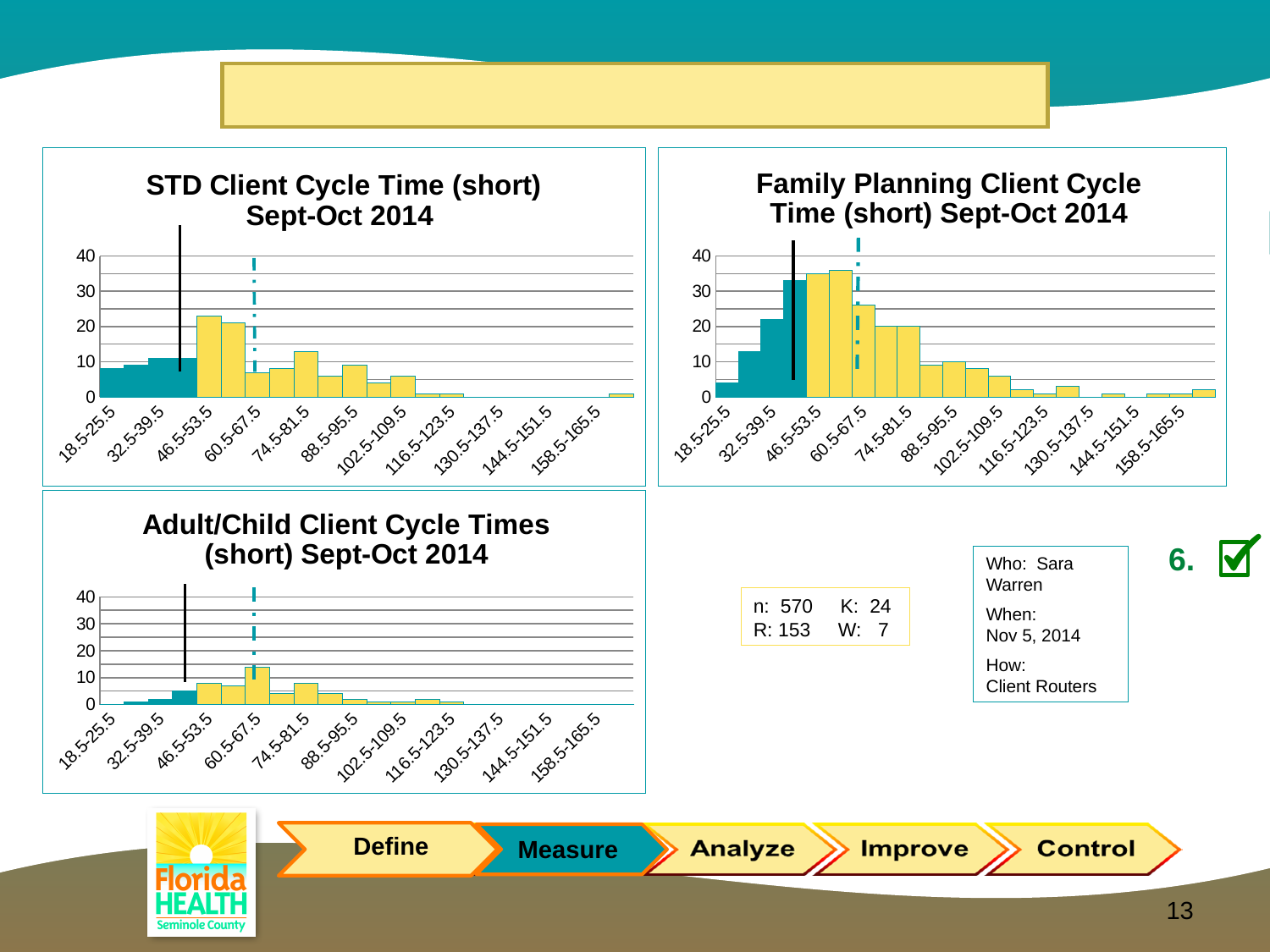
In the "Adult/Child Client Cycle Times (short) Sept-Oct 2014" chart, is the value for 18.5-25.5 greater or less than 10? less Which chart has the tallest bar overall: the STD chart, the Family Planning chart, or the Adult/Child chart? Family Planning Client Cycle Time (short) Sept-Oct 2014 In the "Family Planning Client Cycle Time (short) Sept-Oct 2014" chart, is the tallest bar greater or less than 30? greater In the "Adult/Child Client Cycle Times (short) Sept-Oct 2014" chart, is the tallest bar greater or less than 20? less What is the highest value shown on the y-axis of the "STD Client Cycle Time (short) Sept-Oct 2014" chart? 40 What kind of chart is the "STD Client Cycle Time (short) Sept-Oct 2014" chart? Bar chart How many charts are shown on the slide? 3 How many x-axis labels are printed on the "Family Planning Client Cycle Time (short) Sept-Oct 2014" chart? 11 What time period is named in the title of the "Adult/Child Client Cycle Times (short)" chart? Sept-Oct 2014